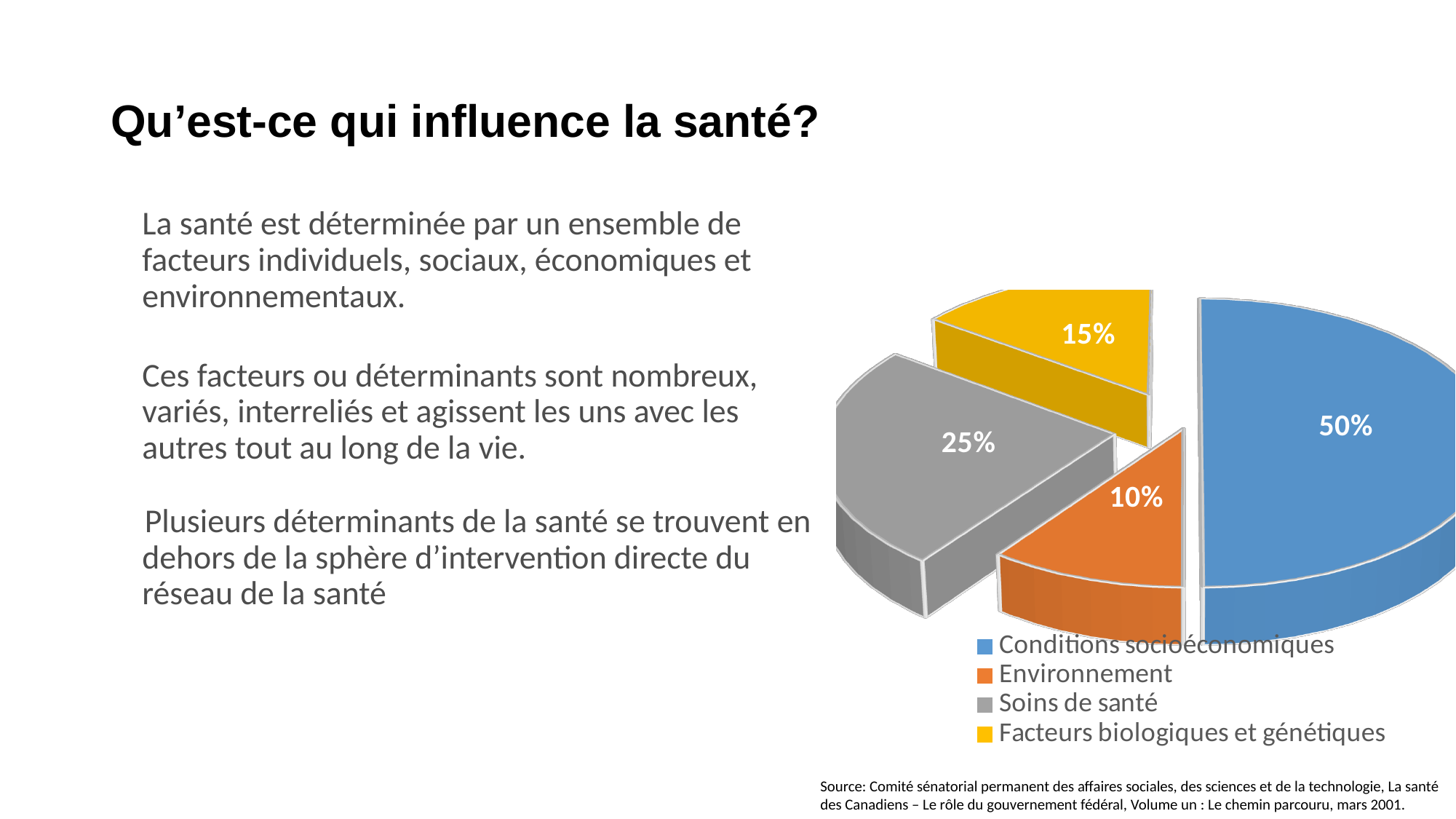
How many categories does the pie chart show? 4 What is the difference between the shares for Soins de santé and Facteurs biologiques et génétiques? 10% What is the value shown for Environnement? 10% What is the value shown for Soins de santé? 25% What kind of chart is shown on the slide? Pie chart What share of the pie does Conditions socioéconomiques represent? 50% Which category has the largest slice of the pie? Conditions socioéconomiques Which category has the smallest slice of the pie? Environnement Which legend entry is shown in orange? Environnement What is the value shown for Facteurs biologiques et génétiques? 15% Which is larger, the share for Soins de santé or the share for Environnement? Soins de santé What colour is the slice for Soins de santé? Grey